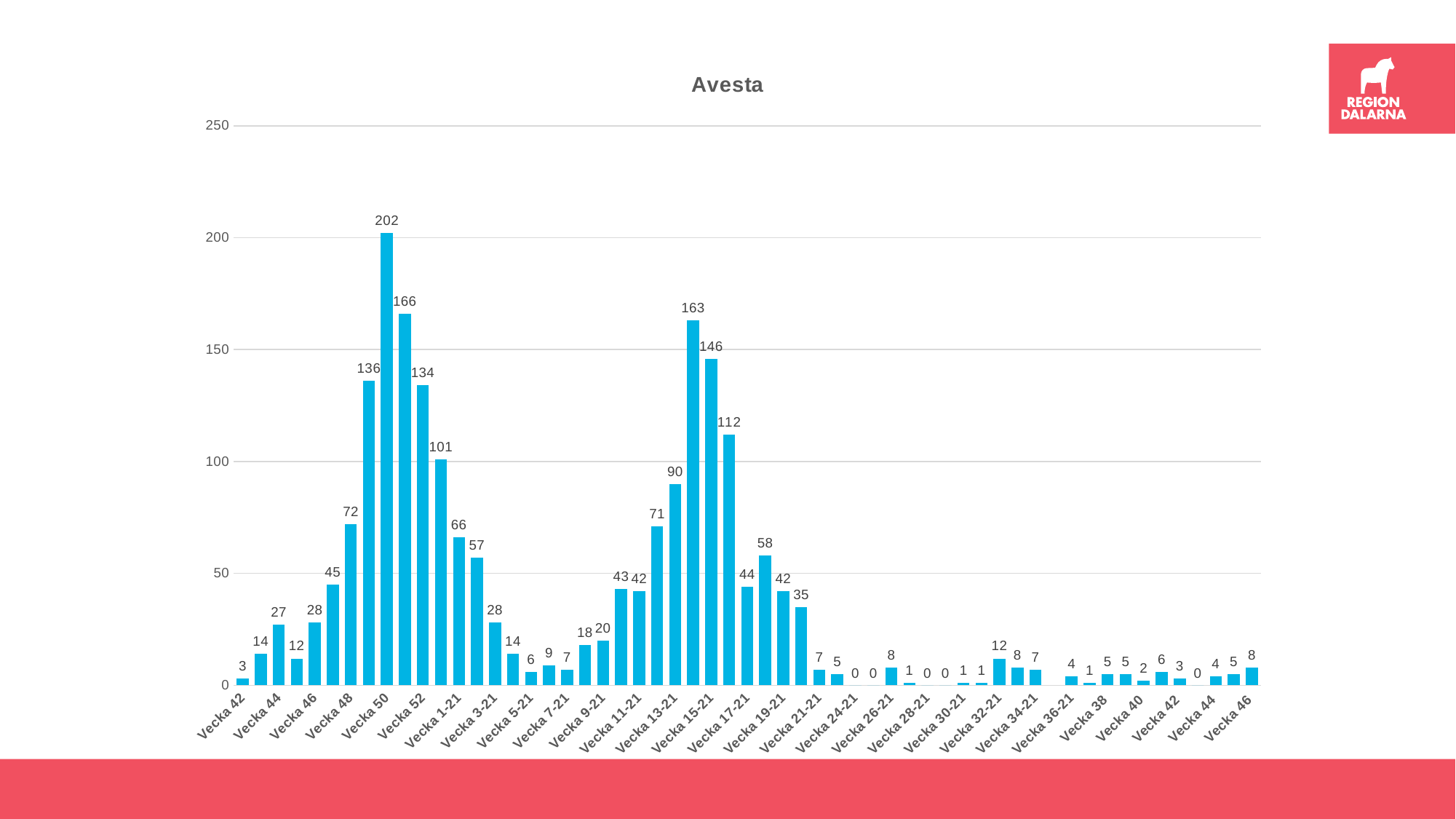
What is the value for Vecka 50? 202 What is the value for Vecka 9-21? 20 What is the value for Vecka 48? 72 What is the value for Vecka 15-21? 146 What is the difference between the values for Vecka 50 and Vecka 52? 68 Which week has the highest value in the Avesta chart? Vecka 50 Do the values rise or fall from Vecka 50 to Vecka 5-21? fall What is the value for Vecka 32-21? 12 What is the difference between the values for Vecka 15-21 and Vecka 13-21? 56 Which has a larger value, Vecka 1-21 or Vecka 3-21? Vecka 1-21 What is the value for Vecka 13-21? 90 What type of chart is shown on the slide? bar chart